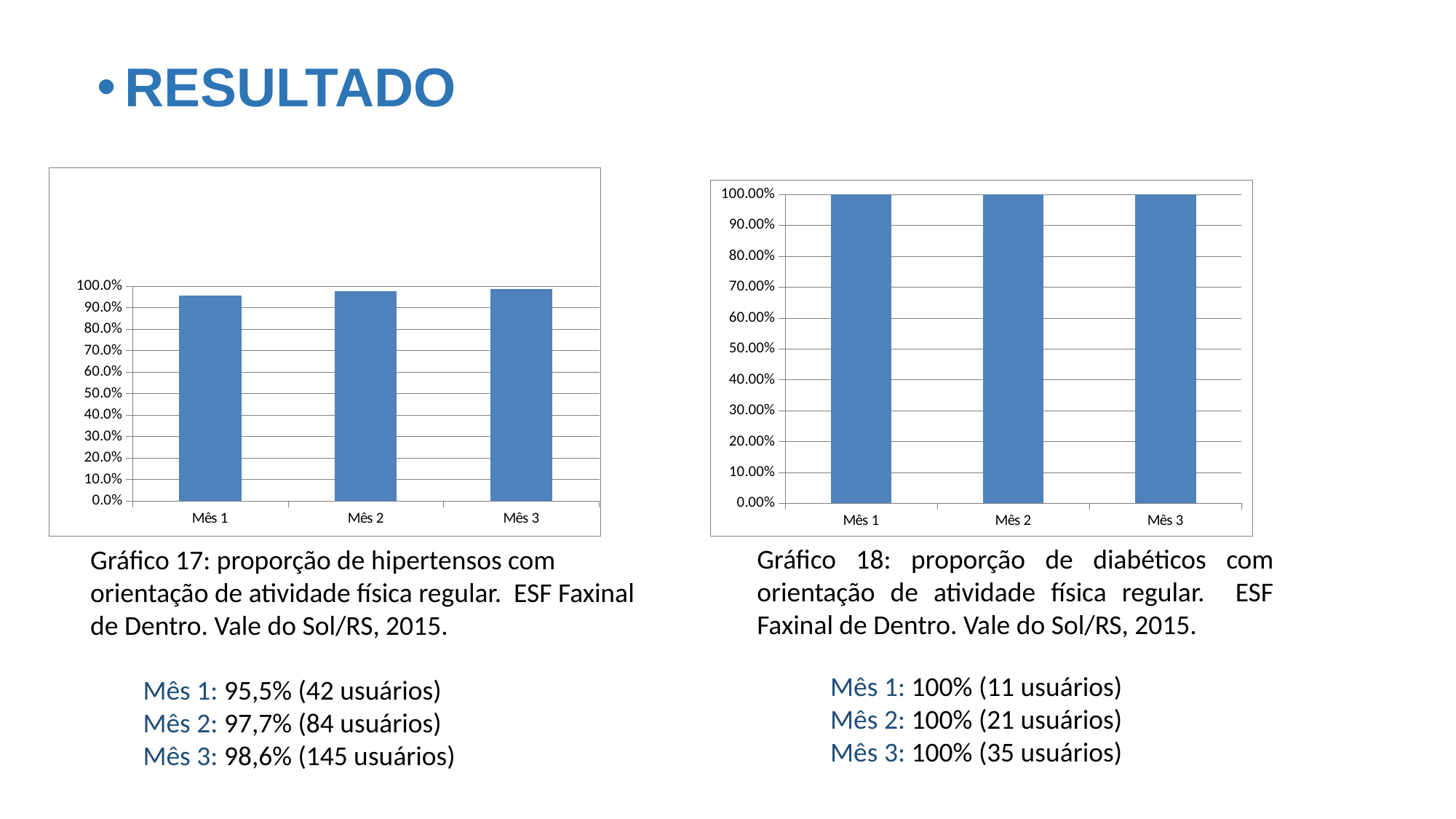
In Gráfico 17 (the left chart), what is the value for Mês 3? 98,6% In Gráfico 17 (the left chart), do the values rise or fall from Mês 1 to Mês 3? rise In Gráfico 17 (the left chart), which month has the lowest value? Mês 1 In Gráfico 17 (the left chart), is the value for Mês 2 greater or less than 90.0%? greater In Gráfico 17 (the left chart), what is the value for Mês 1? 95,5% What kind of chart is Gráfico 17 (the left chart)? bar chart In Gráfico 18 (the right chart), is the value for Mês 3 greater or less than 50.00%? greater In Gráfico 18 (the right chart), what is the value for Mês 2? 100% In Gráfico 17 (the left chart), what is the difference between the values for Mês 3 and Mês 1? 3,2% What colour are the bars in Gráfico 17 (the left chart)? blue What is the highest tick shown on the y axis of Gráfico 18 (the right chart)? 100.00% How many categories are shown on the x axis of Gráfico 18 (the right chart)? 3